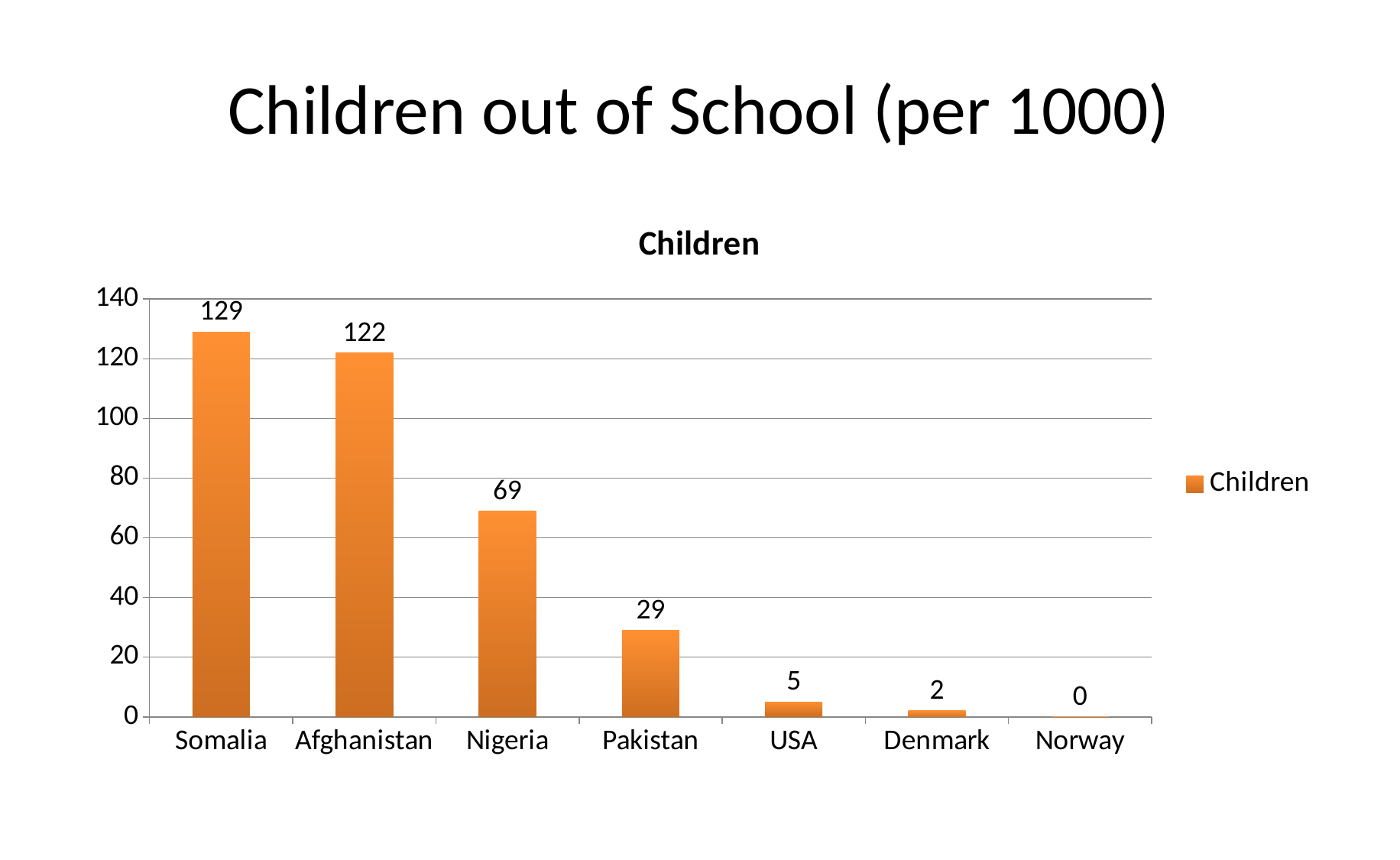
What is the value for Denmark? 2 What kind of chart is shown on the slide? bar chart Is the value for Afghanistan greater or less than 100? greater What is the difference between the values for Somalia and Afghanistan? 7 Which country has the highest value? Somalia What is the title of the slide? Children out of School (per 1000) Which is larger, the value for Pakistan or the value for USA? Pakistan What is the value for Nigeria? 69 What is the value for Somalia? 129 How many countries are shown on the x axis? 7 What is the difference between the values for Nigeria and Pakistan? 40 Which country has the lowest value? Norway